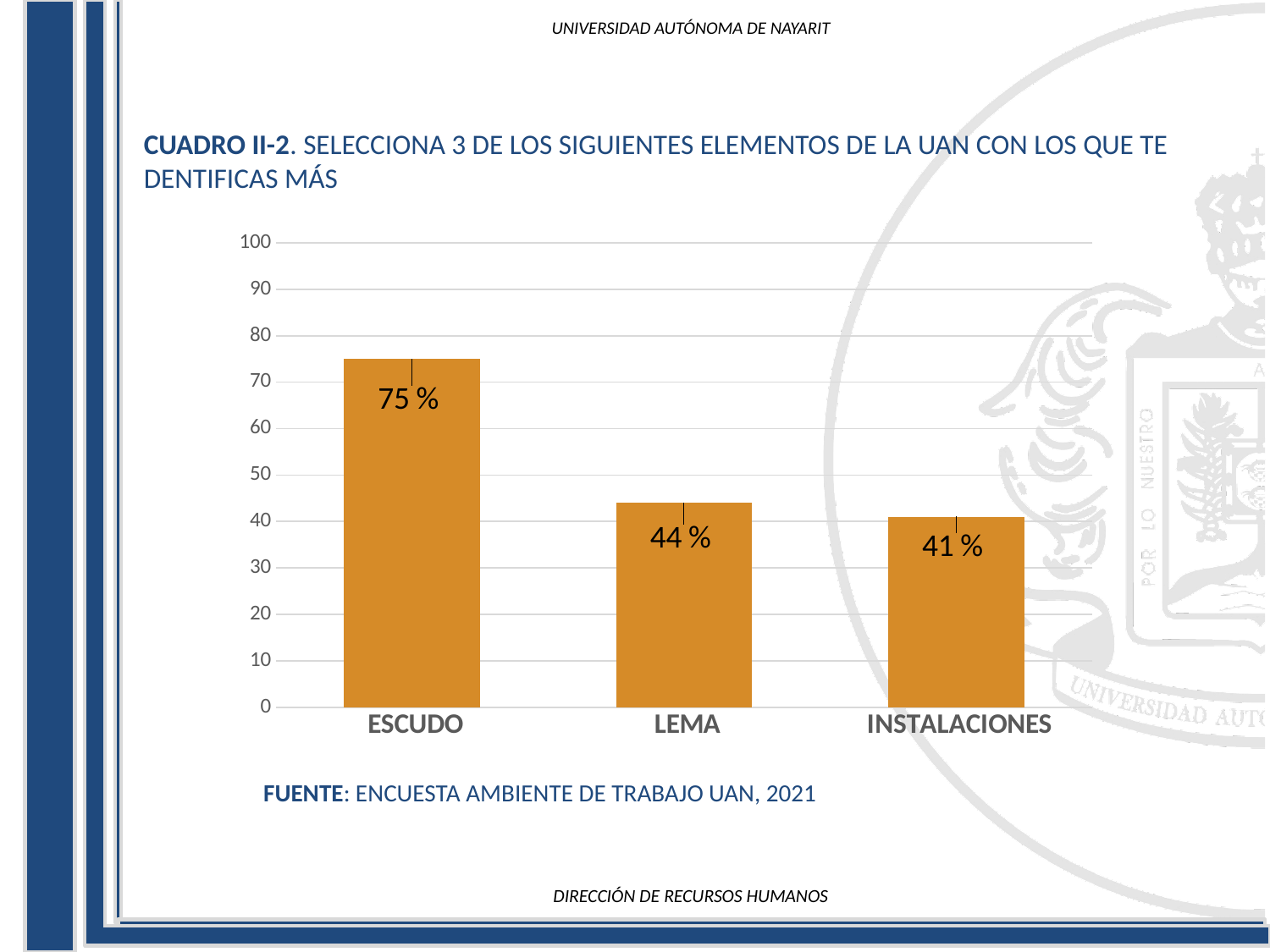
What is the value for INSTALACIONES? 41 % How many categories are shown on the x axis? 3 Do the values rise or fall from left to right along the x axis? fall What kind of chart is shown on the slide? bar chart What is the difference between the values for LEMA and INSTALACIONES? 3 % Which category has the lowest value? INSTALACIONES What is the value for ESCUDO? 75 % What is the difference between the values for ESCUDO and LEMA? 31 % Which category has the highest value? ESCUDO Which is larger, the value for ESCUDO or the value for INSTALACIONES? ESCUDO Is the value for ESCUDO greater or less than 70? greater What is the value for LEMA? 44 %